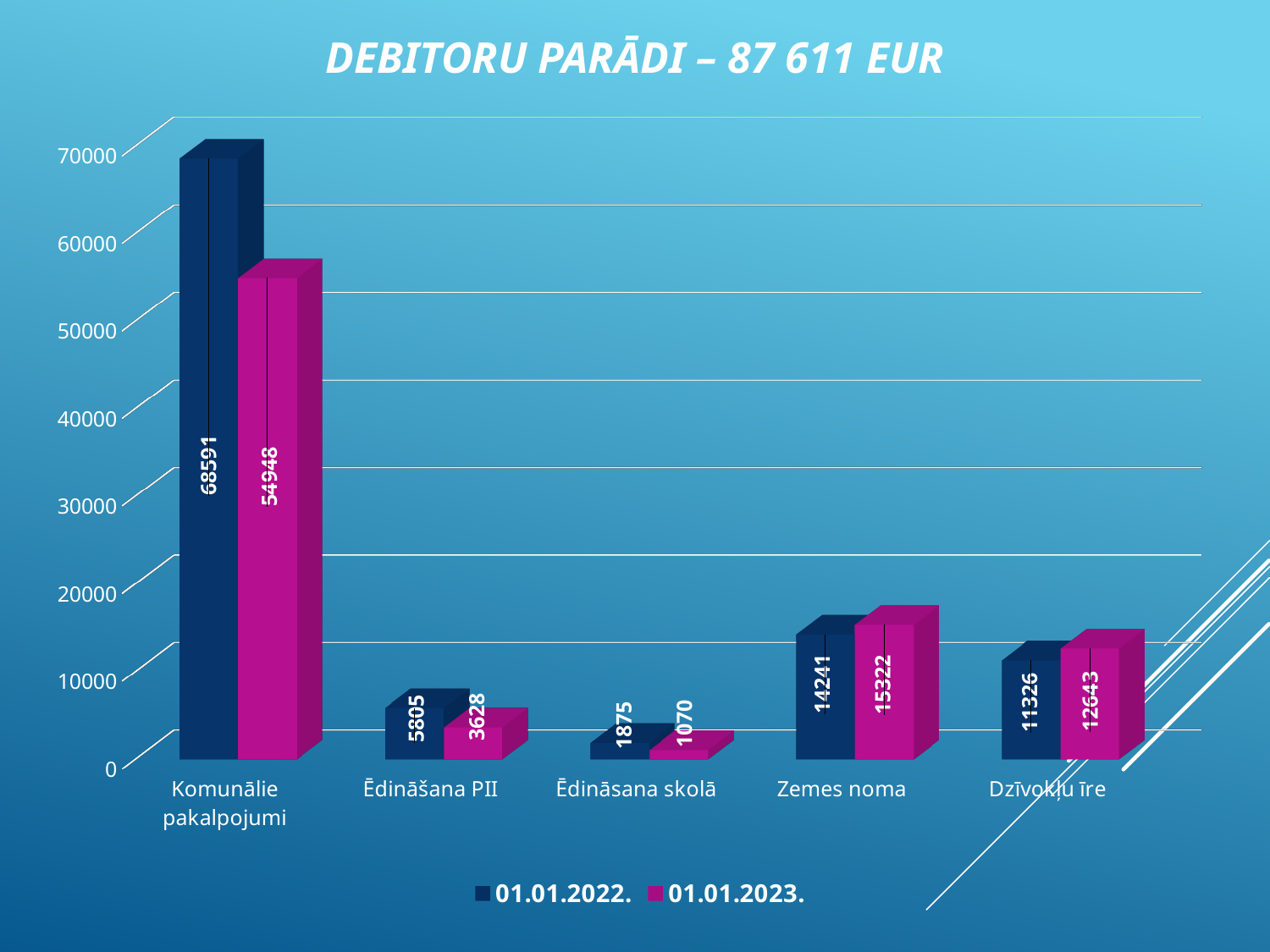
What is the title of the chart? DEBITORU PARĀDI – 87 611 EUR What is the value for Komunālie pakalpojumi in the 01.01.2022. series? 68591 Which category has the highest value in the 01.01.2022. series? Komunālie pakalpojumi For Ēdināšana PII, which series has the larger value, 01.01.2022. or 01.01.2023.? 01.01.2022. How many categories are shown on the x axis? 5 What is the value for Zemes noma in the 01.01.2023. series? 15322 Which category has the lowest value in the 01.01.2023. series? Ēdināsana skolā What is the difference between the 01.01.2023. and 01.01.2022. values for Dzīvokļu īre? 1317 What is the difference between the 01.01.2022. and 01.01.2023. values for Komunālie pakalpojumi? 13643 What is the value for Ēdināsana skolā in the 01.01.2023. series? 1070 Is the 01.01.2023. value for Komunālie pakalpojumi greater or less than 50000? greater How many series does the legend list? 2